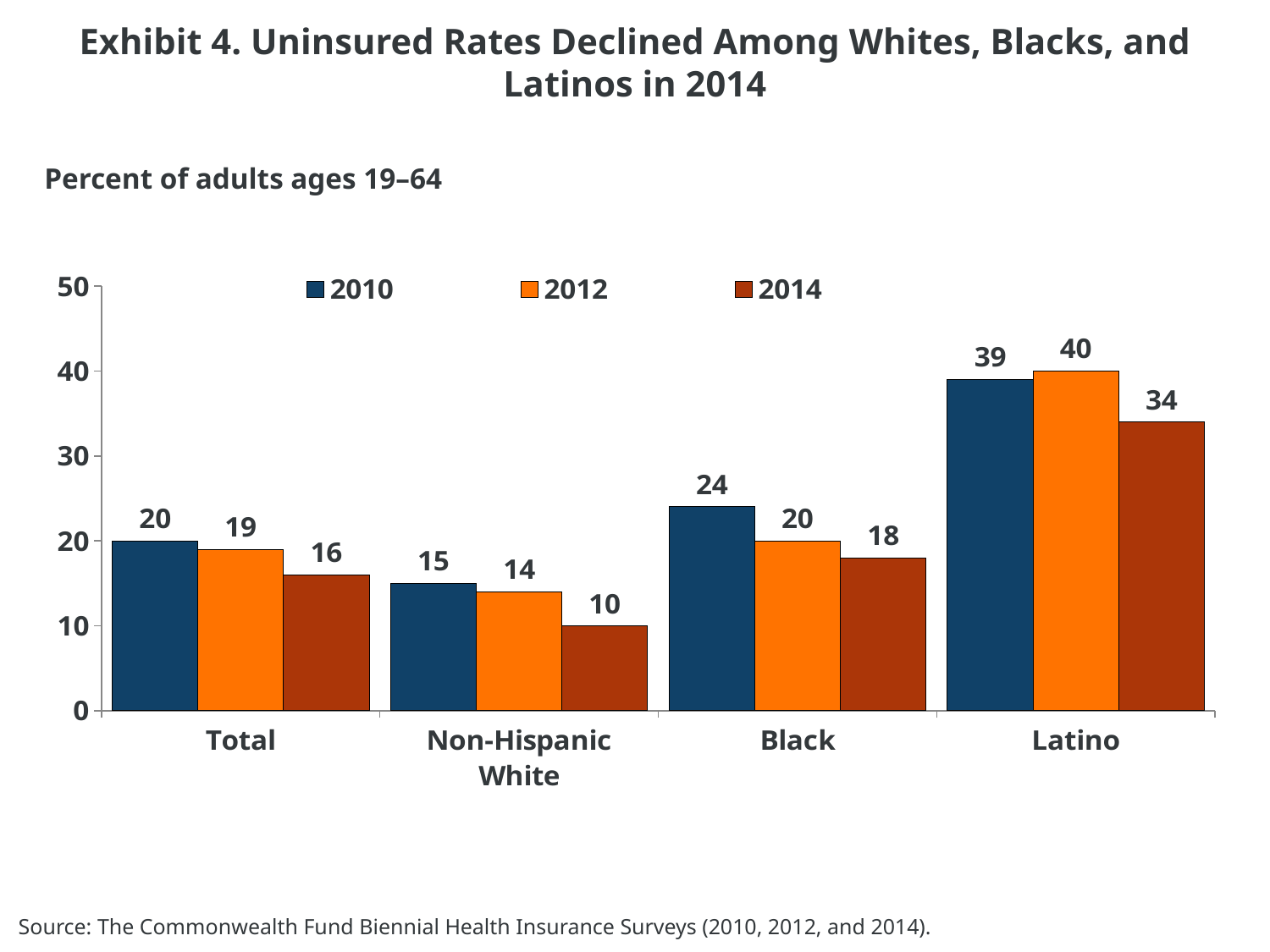
What was the uninsured rate for Non-Hispanic White adults in 2010? 15 By how many percentage points did the uninsured rate for Black adults fall from 2010 to 2014? 6 Which group had the highest uninsured rate in 2012? Latino Which year does the dark blue series represent? 2010 What was the uninsured rate for Latino adults in 2014? 34 Which group had the lowest uninsured rate in 2014? Non-Hispanic White Which was larger for Latino adults: the 2010 rate or the 2012 rate? 2012 How many series does the legend list? 3 What is the difference between the Latino and Non-Hispanic White uninsured rates in 2014? 24 What kind of chart is shown on the slide? Bar chart What was the uninsured rate for Black adults in 2012? 20 How many groups are shown on the x axis? 4